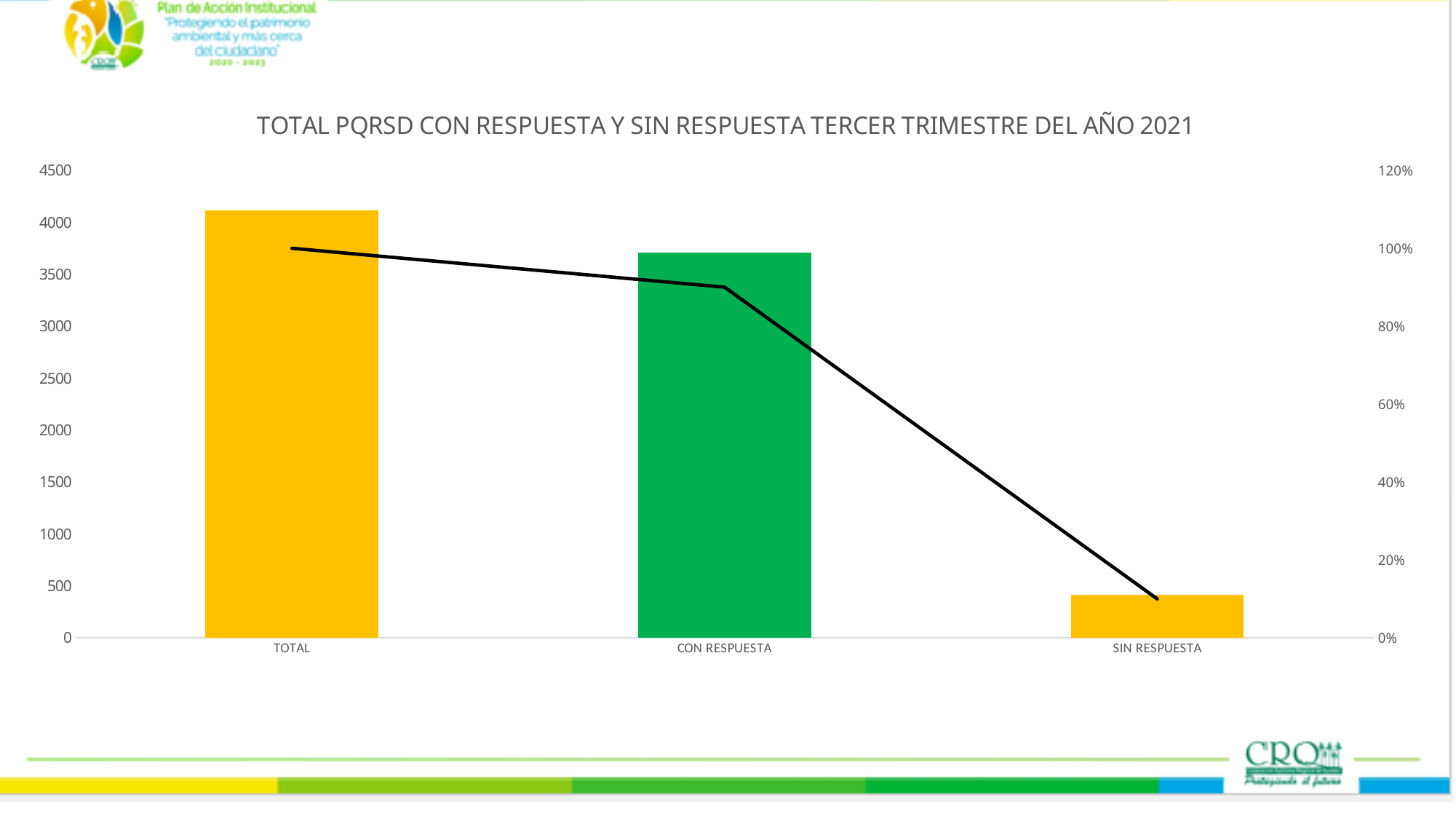
How many categories are shown on the x axis? 3 Which bar is taller, CON RESPUESTA or SIN RESPUESTA? CON RESPUESTA What kind of chart is shown on the slide? bar chart with a line Which category has the shortest bar? SIN RESPUESTA Does the line rise or fall from TOTAL to SIN RESPUESTA? fall What is the title of the chart? TOTAL PQRSD CON RESPUESTA Y SIN RESPUESTA TERCER TRIMESTRE DEL AÑO 2021 What colour is the CON RESPUESTA bar? green Is the bar value for CON RESPUESTA greater or less than 3500? greater Is the bar value for TOTAL greater or less than 4000? greater Is the bar value for SIN RESPUESTA greater or less than 500? less Which category has the tallest bar? TOTAL